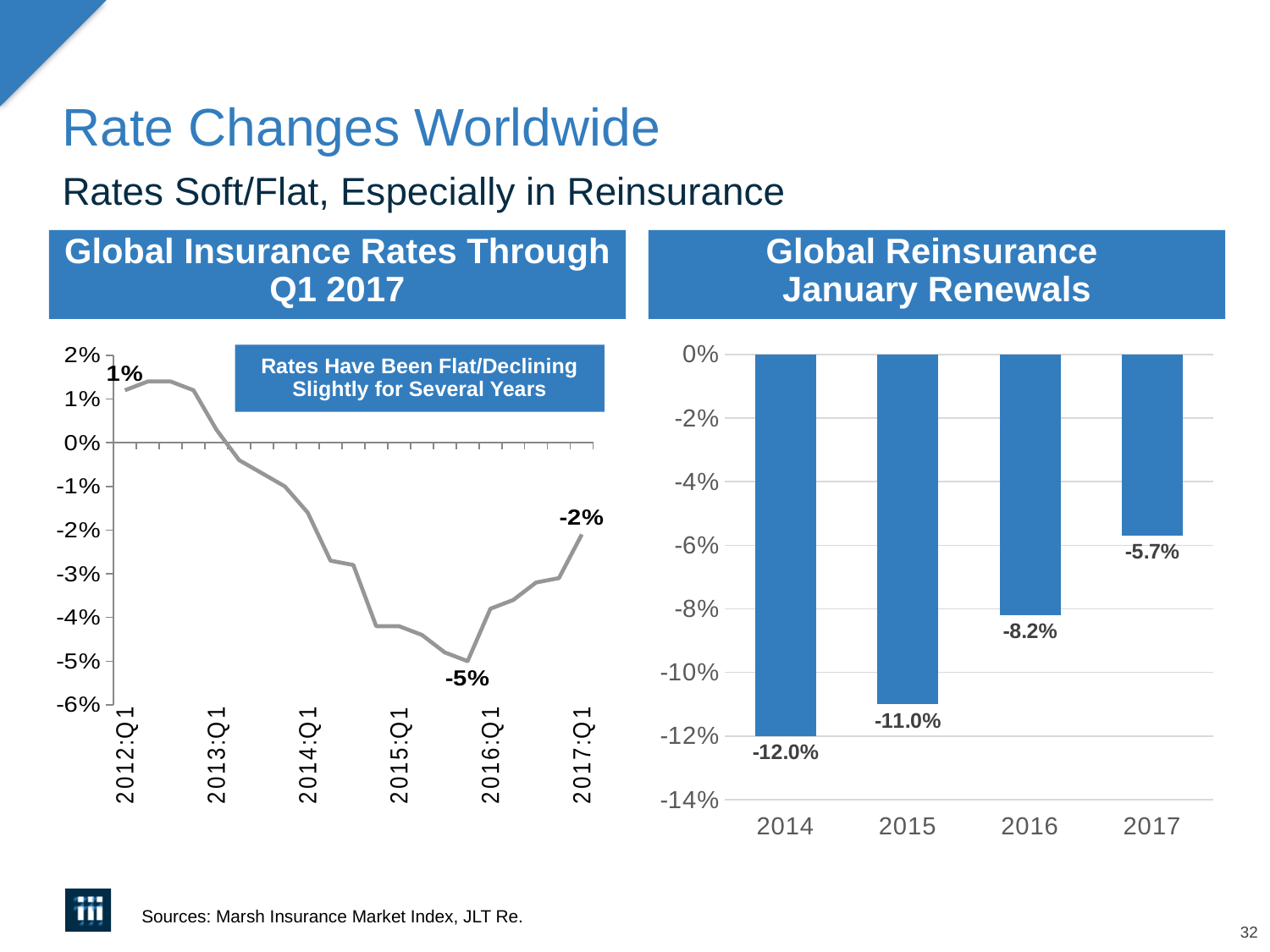
In the Global Reinsurance January Renewals chart, which year has the highest value? 2017 How many years are shown in the Global Reinsurance January Renewals chart? 4 In the Global Reinsurance January Renewals chart, what is the difference between the 2014 and 2017 values? 6.3 percentage points In the Global Reinsurance January Renewals chart, do the values rise or fall from 2014 to 2017? rise In the Global Insurance Rates Through Q1 2017 chart, is the value at 2013:Q1 greater or less than 0%? greater What kind of chart is the Global Insurance Rates Through Q1 2017 chart? line chart In the Global Reinsurance January Renewals chart, which is higher, the value for 2015 or the value for 2016? 2016 In the Global Reinsurance January Renewals chart, what is the value for 2017? -5.7% What kind of chart is the Global Reinsurance January Renewals chart? bar chart In the Global Reinsurance January Renewals chart, which year has the lowest (most negative) value? 2014 In the Global Reinsurance January Renewals chart, what is the value for 2014? -12.0% In the Global Insurance Rates Through Q1 2017 chart, what is the labeled value at 2017:Q1? -2%